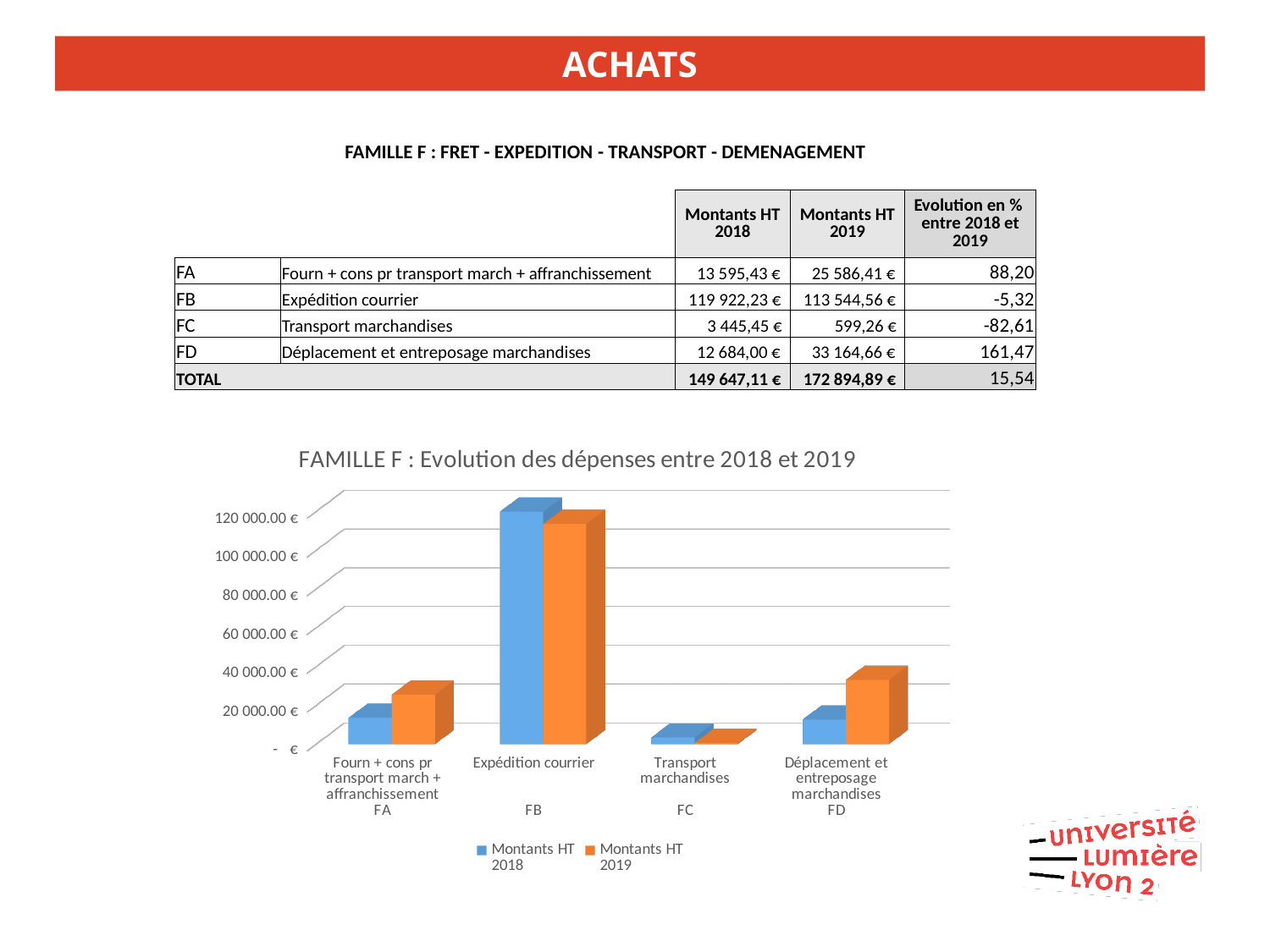
For Montants HT 2019, which is larger: Déplacement et entreposage marchandises or Fourn + cons pr transport march + affranchissement? Déplacement et entreposage marchandises How many series does the chart legend list? 2 Which category has the highest Montants HT 2018 value in the chart? Expédition courrier (FB) What kind of chart is shown on the slide? bar chart What is the title of the chart? FAMILLE F : Evolution des dépenses entre 2018 et 2019 Which category has the lowest Montants HT 2019 value in the chart? Transport marchandises (FC) Is the Montants HT 2019 value for Déplacement et entreposage marchandises greater or less than 40 000.00 €? less How many categories are plotted on the x axis of the chart? 4 Using the values printed in the table, what is the difference between Montants HT 2018 and Montants HT 2019 for Expédition courrier? 6 377,67 € Is the Montants HT 2018 value for Expédition courrier greater or less than 100 000.00 €? greater What is the Montants HT 2019 value for Expédition courrier, as printed in the table above the chart? 113 544,56 € For Fourn + cons pr transport march + affranchissement, which series is larger: Montants HT 2018 or Montants HT 2019? Montants HT 2019